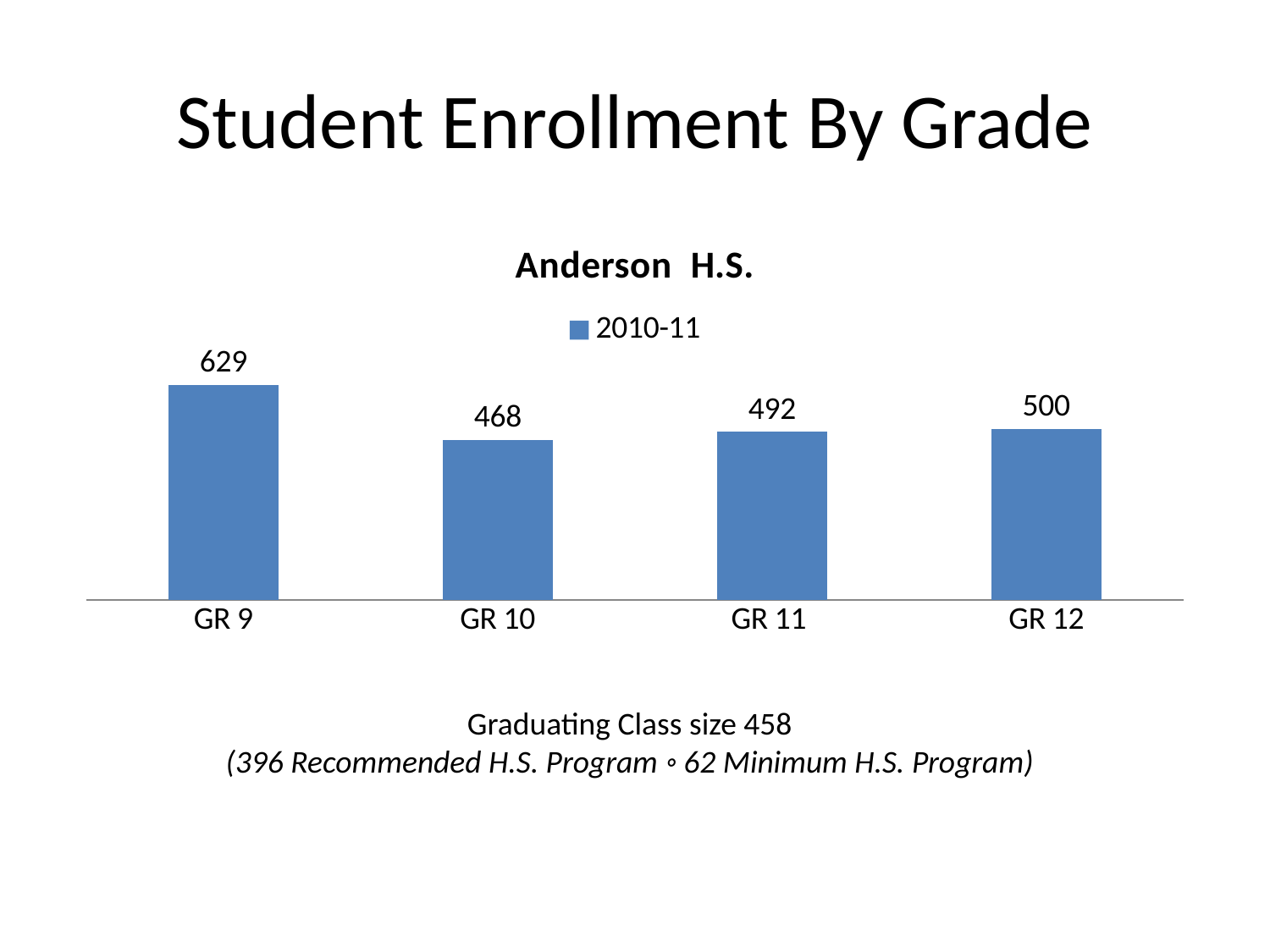
What is the enrollment for GR 12? 500 What is the difference in enrollment between GR 12 and GR 11? 8 Which has a larger enrollment, GR 9 or GR 12? GR 9 How many grade categories are shown in the chart? 4 Which grade has the highest enrollment? GR 9 What is the difference in enrollment between GR 9 and GR 10? 161 What is the enrollment for GR 10? 468 What series does the chart legend list? 2010-11 What kind of chart is shown on the slide? Bar chart What is the enrollment for GR 9? 629 Which grade has the lowest enrollment? GR 10 What is the enrollment for GR 11? 492